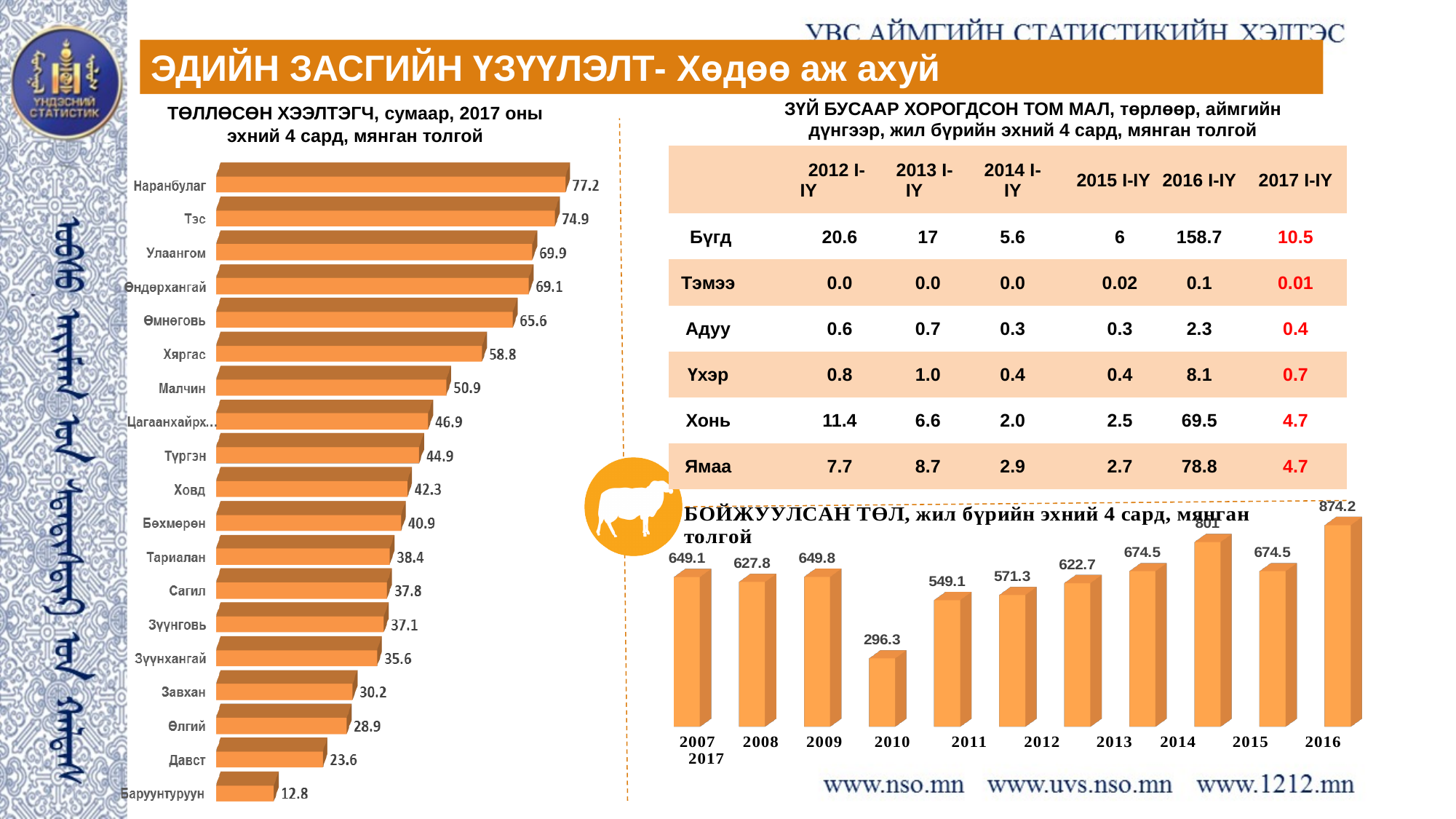
How many sums are shown in the left chart (ТӨЛЛӨСӨН ХЭЭЛТЭГЧ)? 19 In the left chart (ТӨЛЛӨСӨН ХЭЭЛТЭГЧ), what is the difference between Тэс and Давст? 51.3 In the left chart (ТӨЛЛӨСӨН ХЭЭЛТЭГЧ), which sum has the lowest value? Баруунтуруун In the bottom-right chart (БОЙЖУУЛСАН ТӨЛ), do the values rise or fall from 2010 to 2016? Rise In the bottom-right chart (БОЙЖУУЛСАН ТӨЛ), what is the difference between 2015 and 2014? 126.5 In the bottom-right chart (БОЙЖУУЛСАН ТӨЛ), which is larger, 2008 or 2009? 2009 In the left chart (ТӨЛЛӨСӨН ХЭЭЛТЭГЧ), what is the value for Хяргас? 58.8 What type of chart is the left chart (ТӨЛЛӨСӨН ХЭЭЛТЭГЧ)? Bar chart In the left chart (ТӨЛЛӨСӨН ХЭЭЛТЭГЧ), which is larger, Малчин or Түргэн? Малчин In the left chart (ТӨЛЛӨСӨН ХЭЭЛТЭГЧ), what is the value for Наранбулаг? 77.2 In the bottom-right chart (БОЙЖУУЛСАН ТӨЛ), which year has the lowest value? 2010